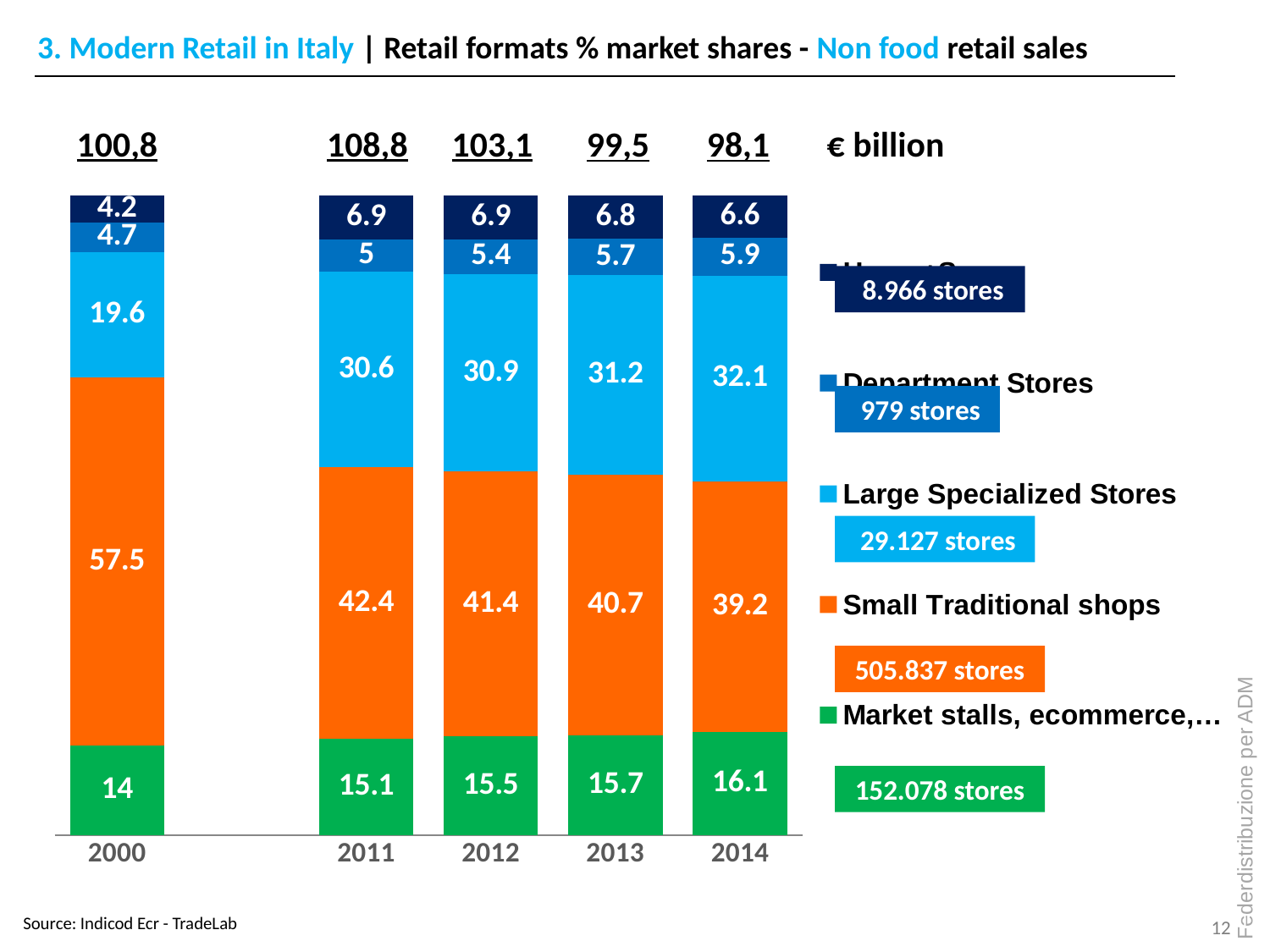
How many stores are shown for Large Specialized Stores in the legend area? 29.127 stores What is the value for Market stalls, ecommerce in 2012? 15.5 Which year has the larger Large Specialized Stores value, 2011 or 2013? 2013 What kind of chart is shown on the slide? stacked bar chart What is the value for Large Specialized Stores in 2014? 32.1 Does the Large Specialized Stores share rise or fall from 2011 to 2014? rise What is the € billion figure shown above the 2011 bar? 108,8 In which year is the Small Traditional shops share highest? 2000 How many years are shown on the x axis? 5 What is the difference between the Small Traditional shops value in 2000 and in 2014? 18.3 In which year is the Market stalls, ecommerce share lowest? 2000 What is the value for Small Traditional shops in 2000? 57.5